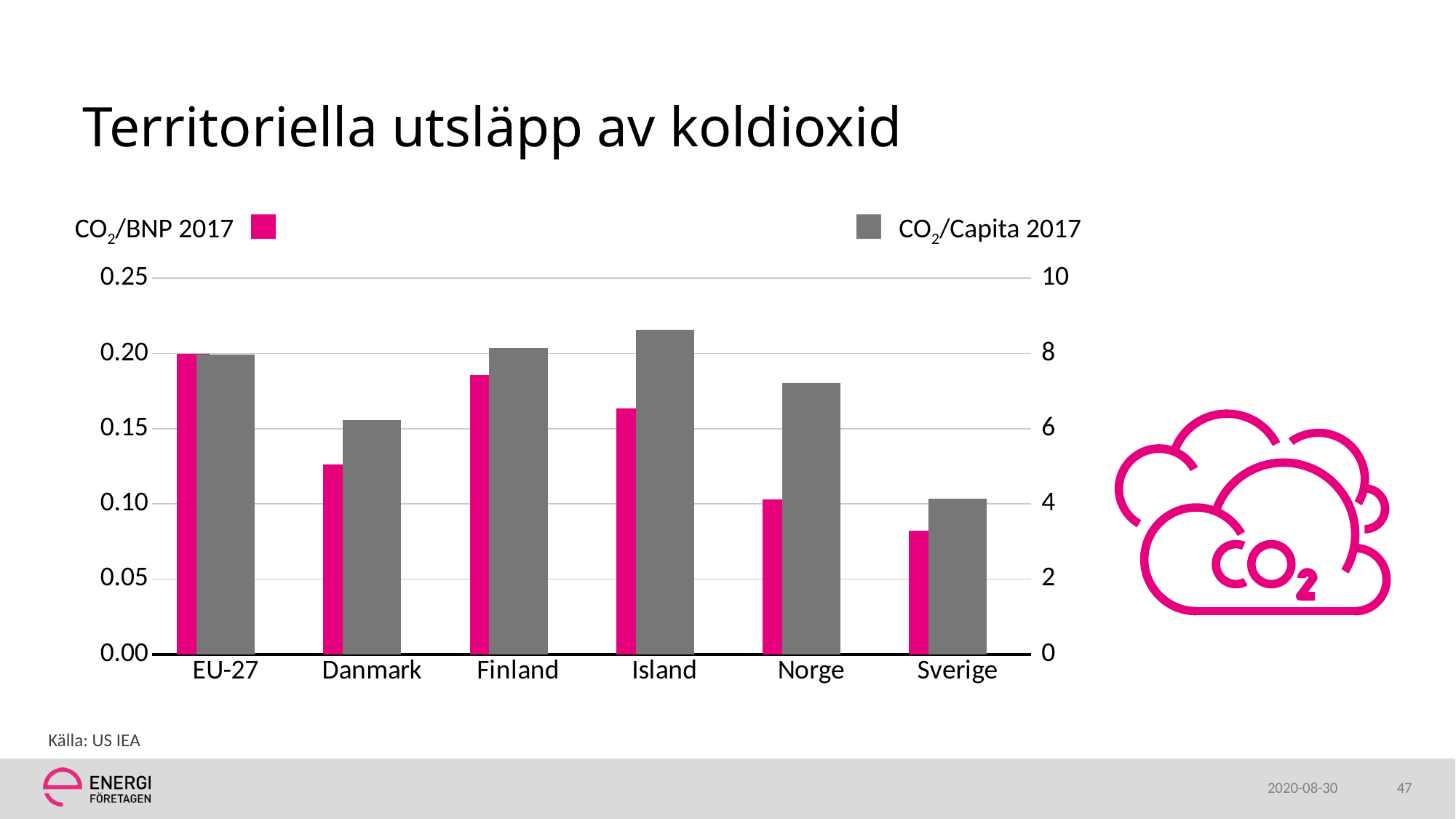
Is the CO2/BNP 2017 value for Danmark greater or less than 0.15? less Which category has the highest CO2/BNP 2017 value? EU-27 Which category has the lowest CO2/Capita 2017 value? Sverige What is the title of the chart on the slide? Territoriella utsläpp av koldioxid How many series does the chart's legend list? 2 Is the CO2/Capita 2017 value for Norge greater or less than 6? greater How many countries or regions are shown on the x axis of the chart? 6 Which category has the highest CO2/Capita 2017 value? Island What kind of chart is shown on the slide? bar chart Is the CO2/Capita 2017 value for Island greater or less than 8? greater Which category has the lowest CO2/BNP 2017 value? Sverige Which has the larger CO2/BNP 2017 value, Finland or Danmark? Finland